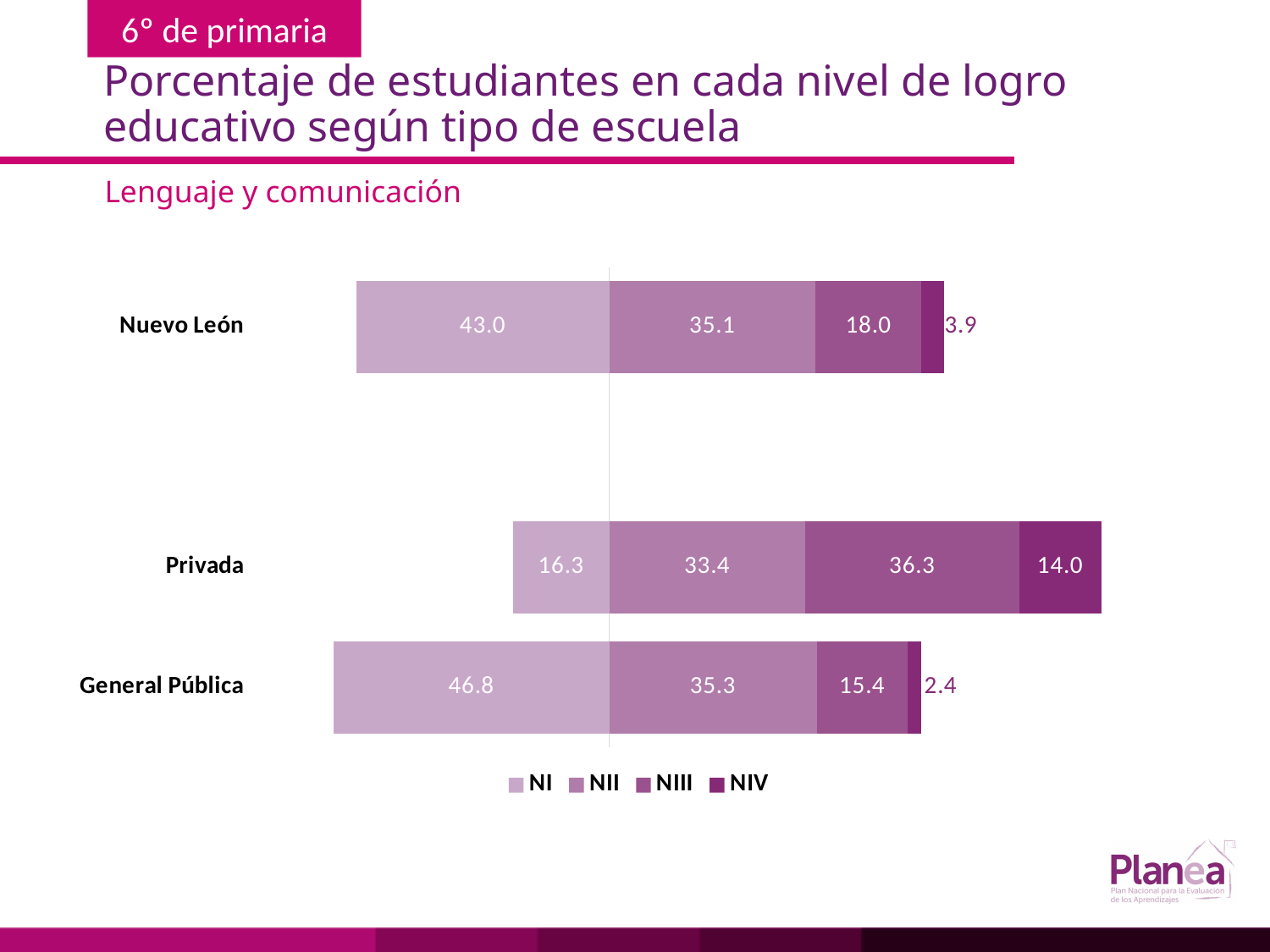
How many categories are shown on the chart? 3 Which is larger, the NII value for Nuevo León or the NII value for Privada? Nuevo León What subject is named in the subtitle above the chart? Lenguaje y comunicación What is the total of the stacked bar for Privada? 100.0 What is the difference between the NIII values for Privada and General Pública? 20.9 What kind of chart is shown on the slide? Stacked bar chart Which category has the lowest NIV value? General Pública What is the NI value for Nuevo León? 43.0 Which category has the highest NI value? General Pública How many series does the legend list? 4 What is the NIV value for Privada? 14.0 What is the NIII value for General Pública? 15.4